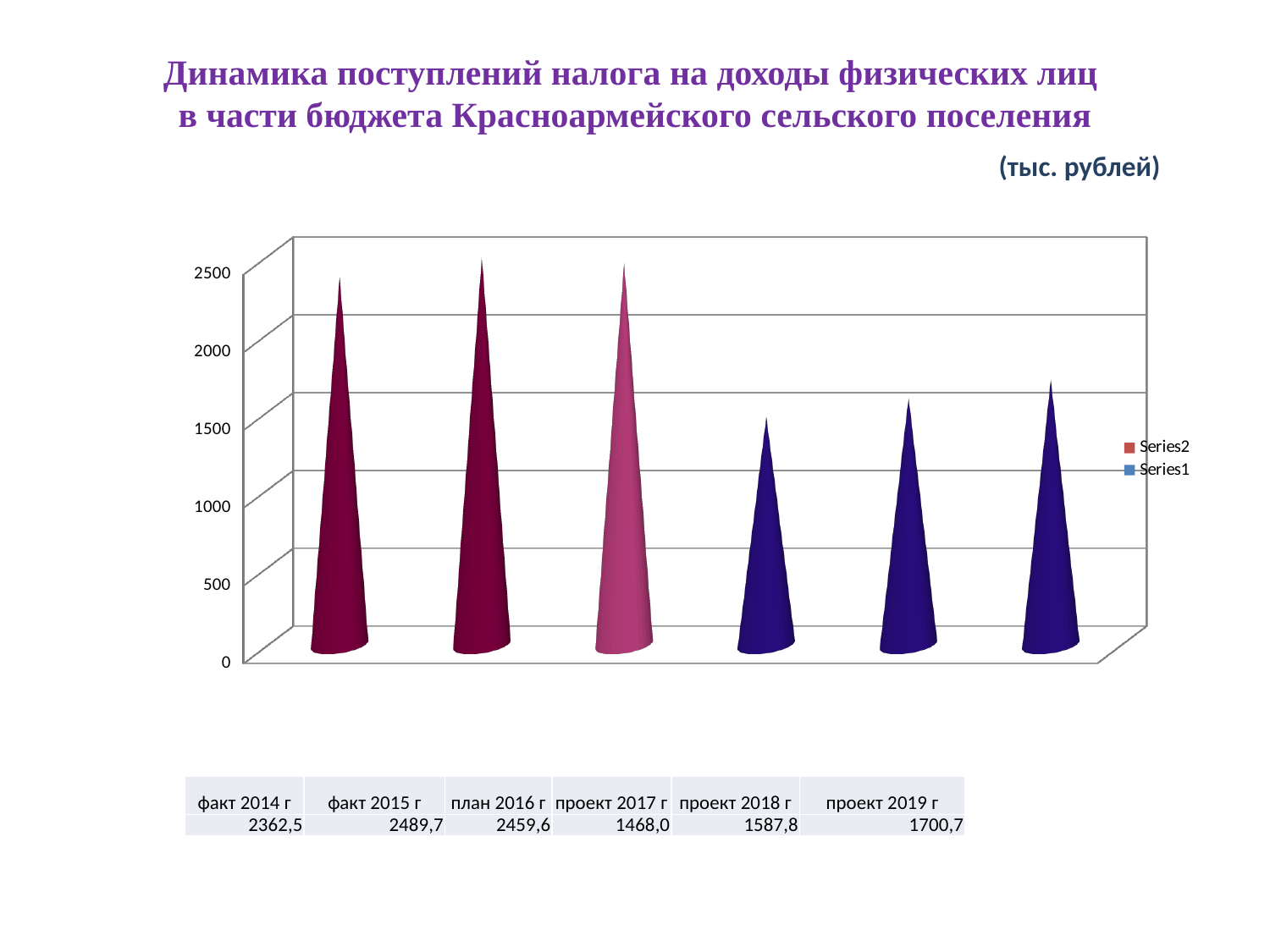
Which is larger, the value for факт 2014 г or the value for проект 2019 г? факт 2014 г What is the difference between the values for проект 2019 г and проект 2017 г? 232,7 What is the value for факт 2014 г? 2362,5 Which category has the lowest value? проект 2017 г Do the values rise or fall from проект 2017 г to проект 2019 г? rise Which category has the highest value? факт 2015 г How many categories are shown on the chart? 6 What is the value for план 2016 г? 2459,6 What is the difference between the values for факт 2015 г and проект 2017 г? 1021,7 What is the value for проект 2018 г? 1587,8 How many series does the legend list? 2 Is the value for проект 2018 г greater or less than 2000? less